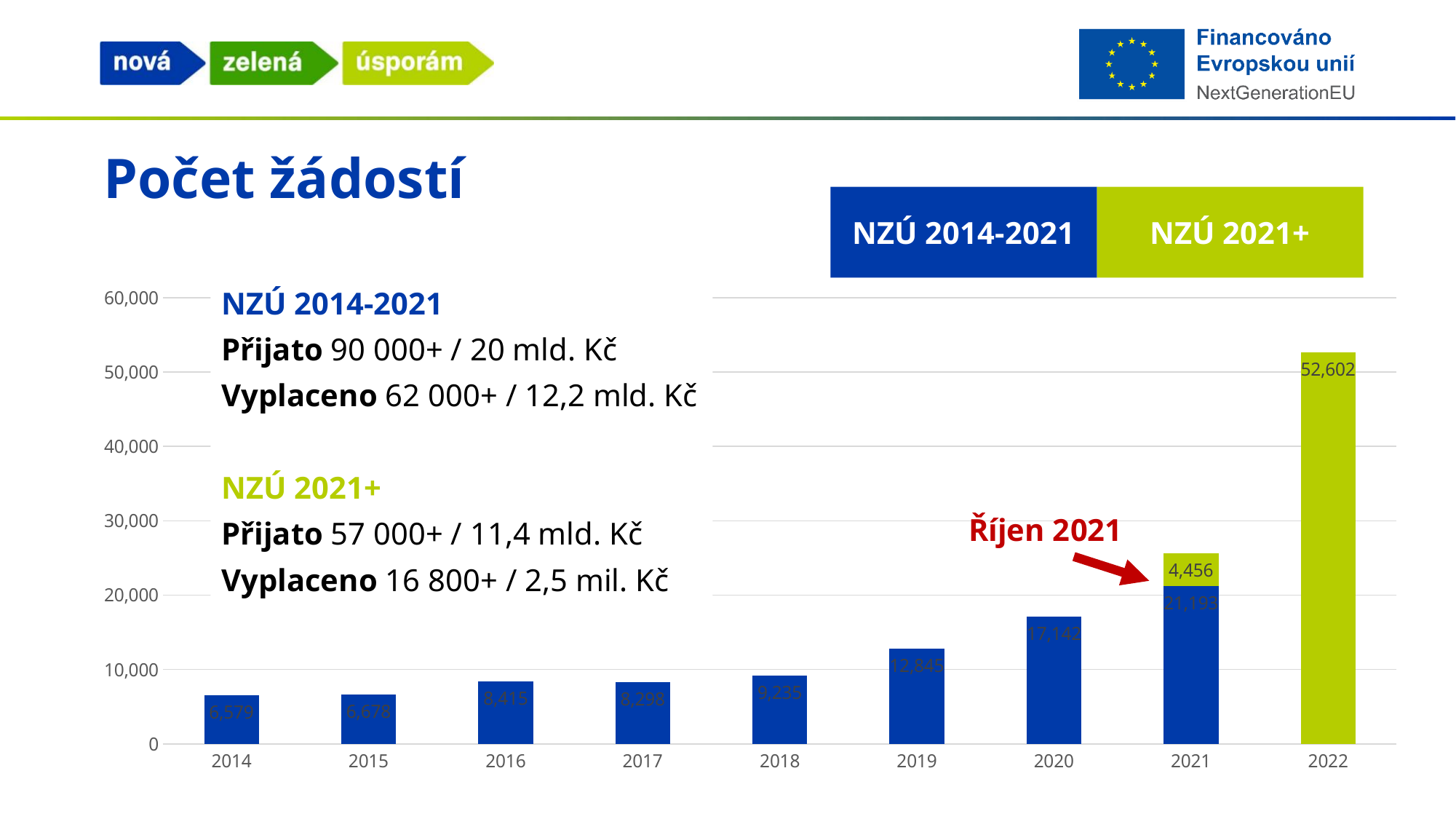
Is the value for 2022 greater or less than 50,000? greater What is the difference between the values for 2022 and 2020? 35,460 Which year has the lowest value in the chart? 2014 Which is larger, the value for 2016 or the value for 2017? 2016 What is the NZÚ 2021+ value for 2021 in the chart? 4,456 What is the value for 2019 in the chart? 12,845 How many years are shown on the x axis of the chart? 9 What is the value for 2014 in the chart? 6,579 What is the total of the stacked bar for 2021? 25,649 Which year has the highest value in the chart? 2022 What is the NZÚ 2014-2021 value for 2021 in the chart? 21,193 How many series does the legend list? 2